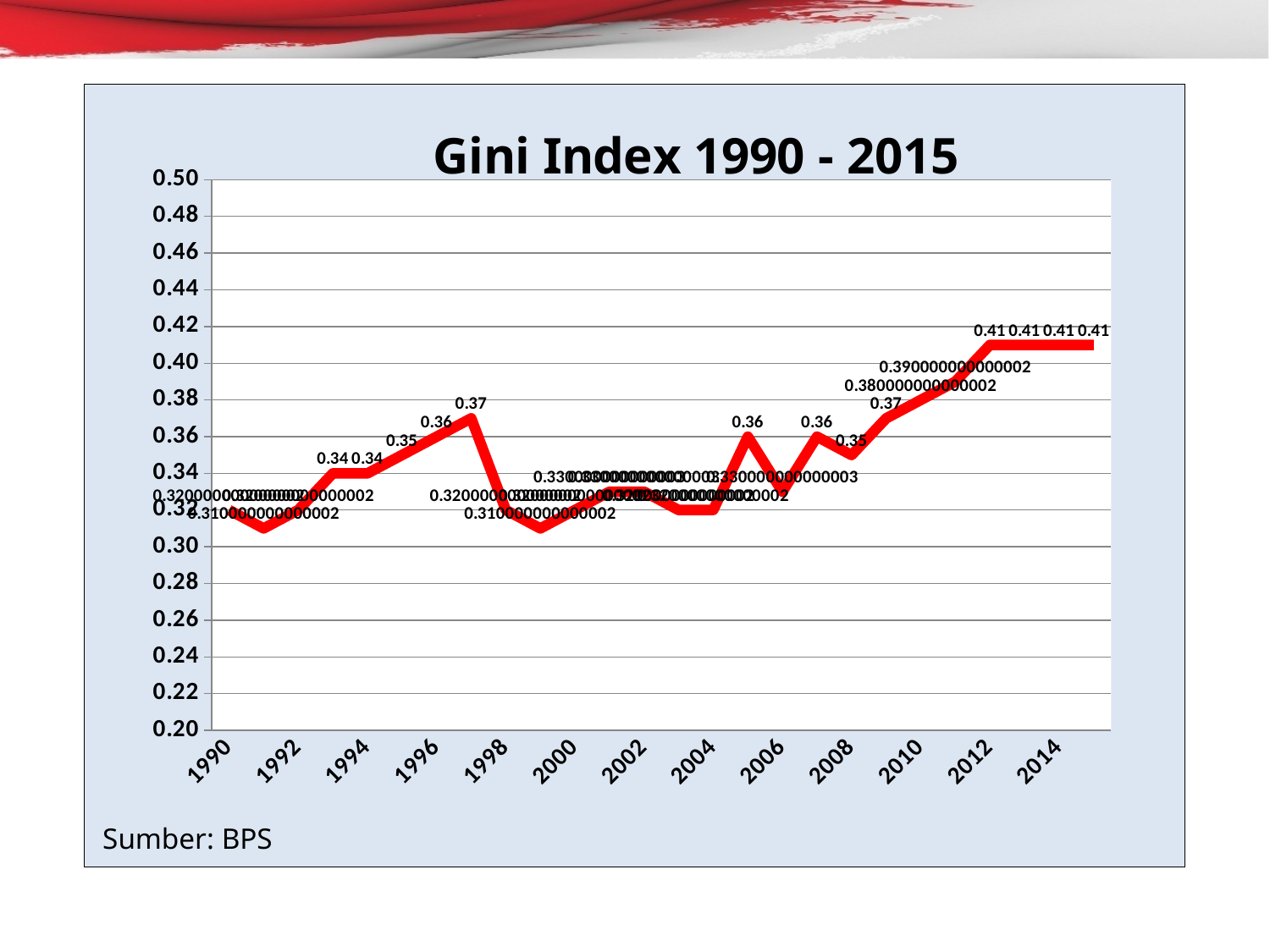
What is the Gini Index value for 2008? 0.35 What is the highest Gini Index value shown on the chart? 0.41 Does the Gini Index rise or fall from 2008 to 2012? Rise What source is cited below the chart? BPS Which year has the larger Gini Index, 1997 or 2005? 1997 What is the Gini Index value for 2005? 0.36 What is the Gini Index value for 1997? 0.37 Is the Gini Index value for 2010 greater or less than 0.36? greater What is the Gini Index value for 2012? 0.41 What is the title of the chart? Gini Index 1990 - 2015 What kind of chart is shown on the slide? Line chart What is the difference between the Gini Index in 2012 and in 1997? 0.04